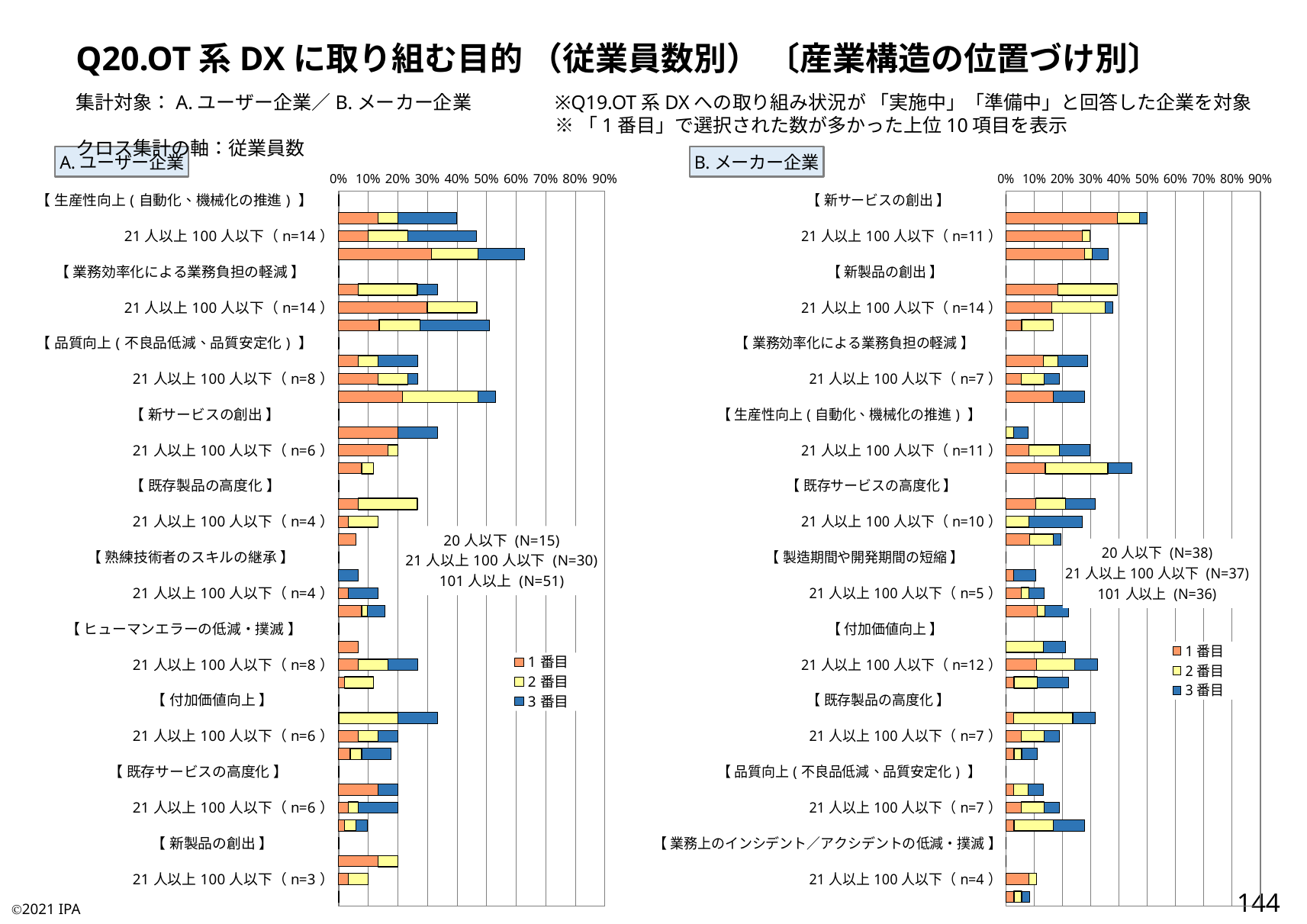
What are the legend entries of the A. ユーザー企業 chart? 1番目, 2番目, 3番目 What kind of chart is the A. ユーザー企業 chart on the left? bar chart In the B. メーカー企業 chart, which is longer: the 21人以上100人以下 bar under 付加価値向上 (n=12) or the 21人以上100人以下 bar under 業務上のインシデント／アクシデントの低減・撲滅 (n=4)? 付加価値向上 In the A. ユーザー企業 chart, which purpose category contains the longest stacked bar? 生産性向上（自動化、機械化の推進） How many purpose categories (the bracketed headings) are shown in the A. ユーザー企業 chart? 10 How many series does the legend of the B. メーカー企業 chart list? 3 In the A. ユーザー企業 chart, which is longer: the 21人以上100人以下 bar under 生産性向上（自動化、機械化の推進） (n=14) or the 21人以上100人以下 bar under 新製品の創出 (n=3)? 生産性向上（自動化、機械化の推進） In the B. メーカー企業 chart, is the total bar length for 21人以上100人以下 (n=14) under 新製品の創出 greater or less than 30%? greater In the B. メーカー企業 chart, which purpose category contains the longest stacked bar? 新サービスの創出 In the A. ユーザー企業 chart, what is the n value shown for 21人以上100人以下 under 品質向上（不良品低減、品質安定化）? n=8 In the A. ユーザー企業 chart, is the total bar length for 21人以上100人以下 (n=14) under 生産性向上（自動化、機械化の推進） greater or less than 40%? greater How many purpose categories (the bracketed headings) are shown in the B. メーカー企業 chart? 10